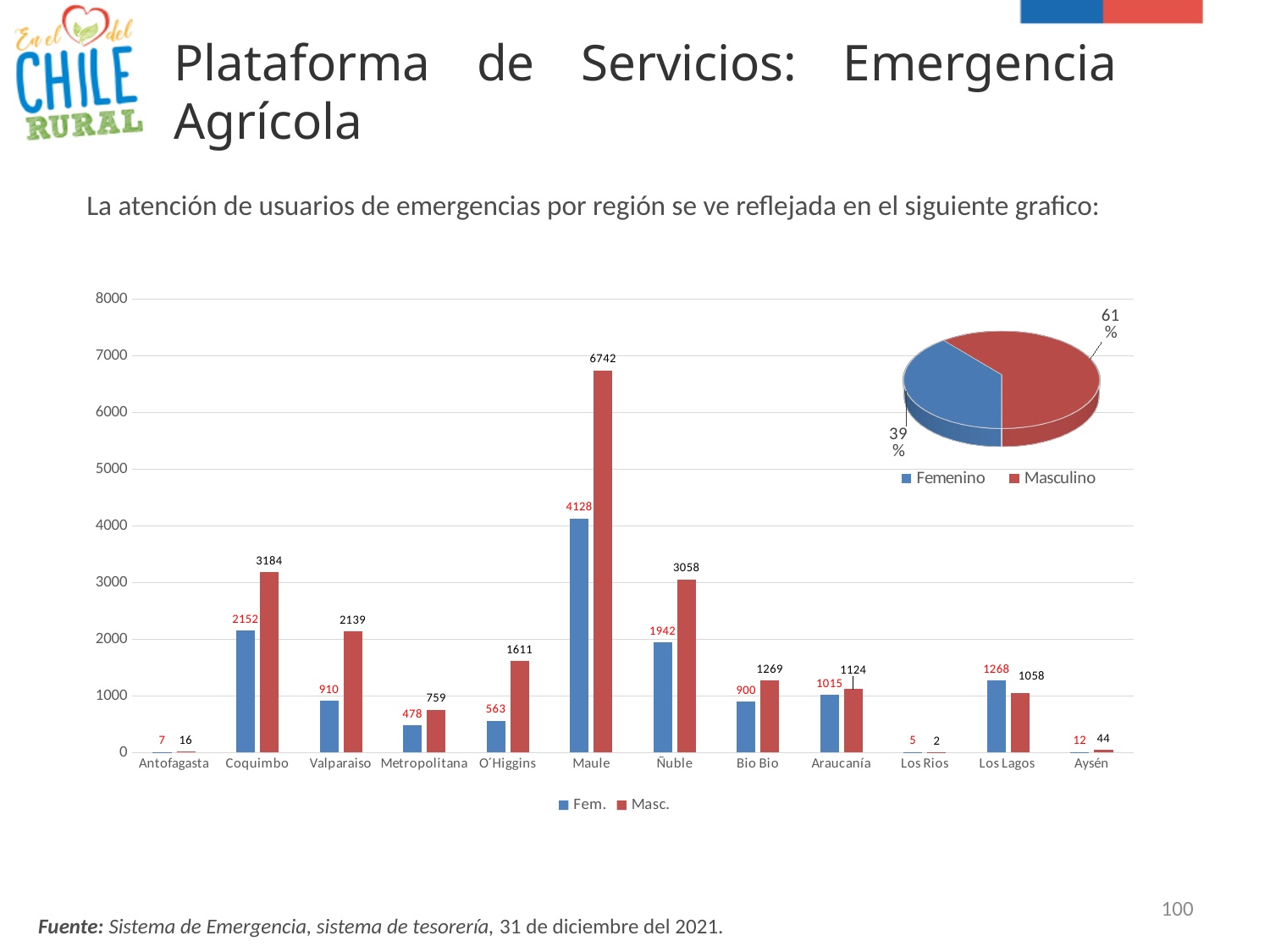
In the pie chart, what share is Masculino? 61% In the bar chart, how many regions are shown on the x axis? 12 In the bar chart, which region has the highest Masc. value? Maule In the bar chart, what is the Masc. value for Maule? 6742 In the bar chart, how many series does the legend list? 2 In the bar chart, what is the difference between the Masc. and Fem. values for Valparaiso? 1229 In the bar chart, which is larger for Los Lagos, the Fem. value or the Masc. value? Fem. In the bar chart, what is the total of the Fem. and Masc. values for Aysén? 56 What kind of chart is the large chart on the left of the slide? Bar chart In the pie chart, what share is Femenino? 39% In the bar chart, which region has the lowest Fem. value? Los Rios In the bar chart, what is the Fem. value for Coquimbo? 2152